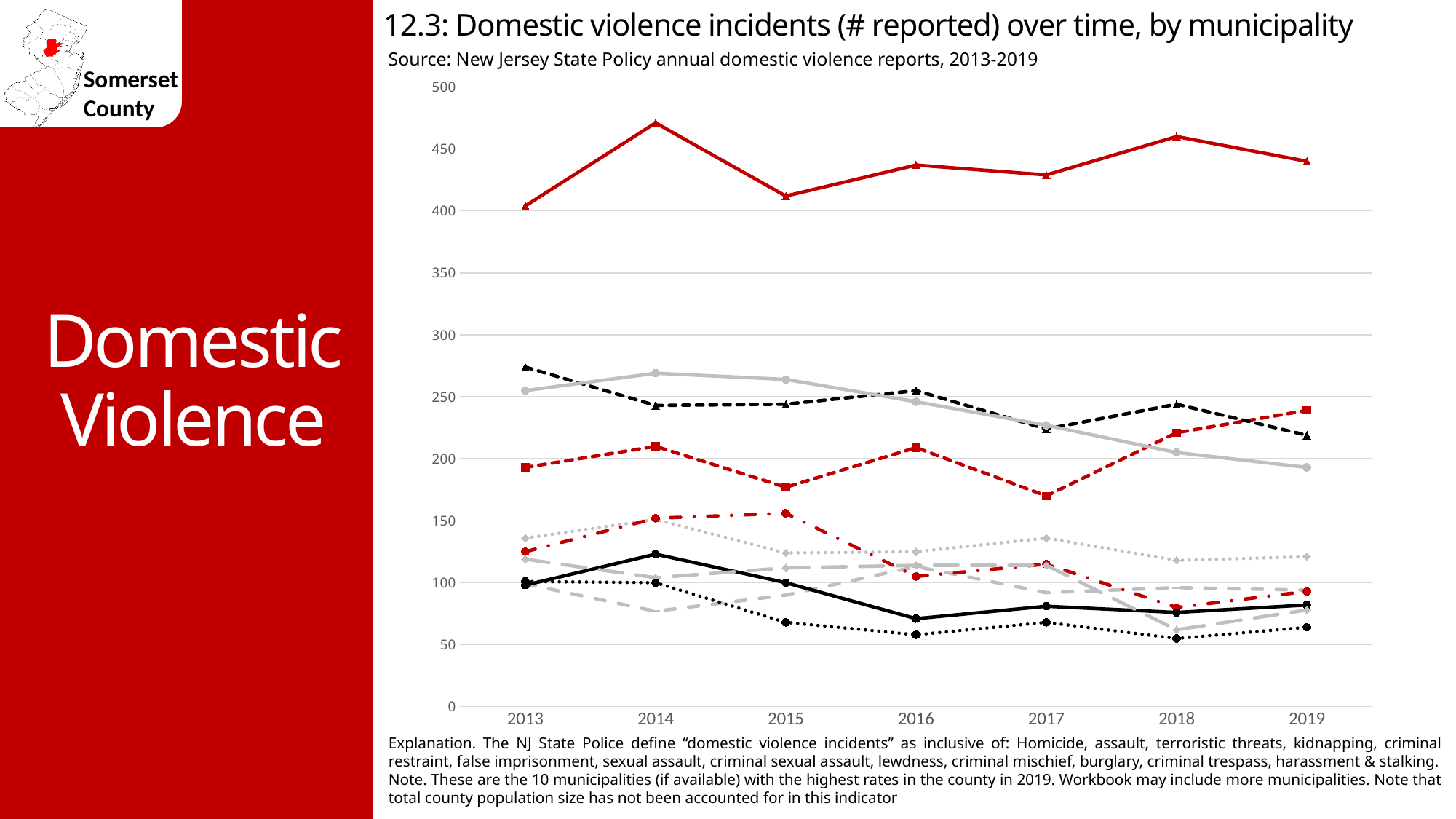
How many years are shown along the x axis of the chart? 7 What is the title of the chart? 12.3: Domestic violence incidents (# reported) over time, by municipality Is the value of the topmost (solid red) line in 2018 greater or less than 450? greater What source is cited for the chart data? New Jersey State Policy annual domestic violence reports, 2013-2019 Does the solid gray line with circle markers rise or fall from 2014 to 2019? fall In which year does the topmost (solid red) line have its lowest value? 2013 How many lines (municipalities) are plotted on the chart? 10 What kind of chart is shown on the slide? line chart Is the value of the topmost (solid red) line in 2016 greater or less than 450? less Is the value of the topmost (solid red) line in 2014 greater or less than 450? greater In which year does the topmost (solid red) line reach its highest value? 2014 What is the first year shown on the x axis? 2013